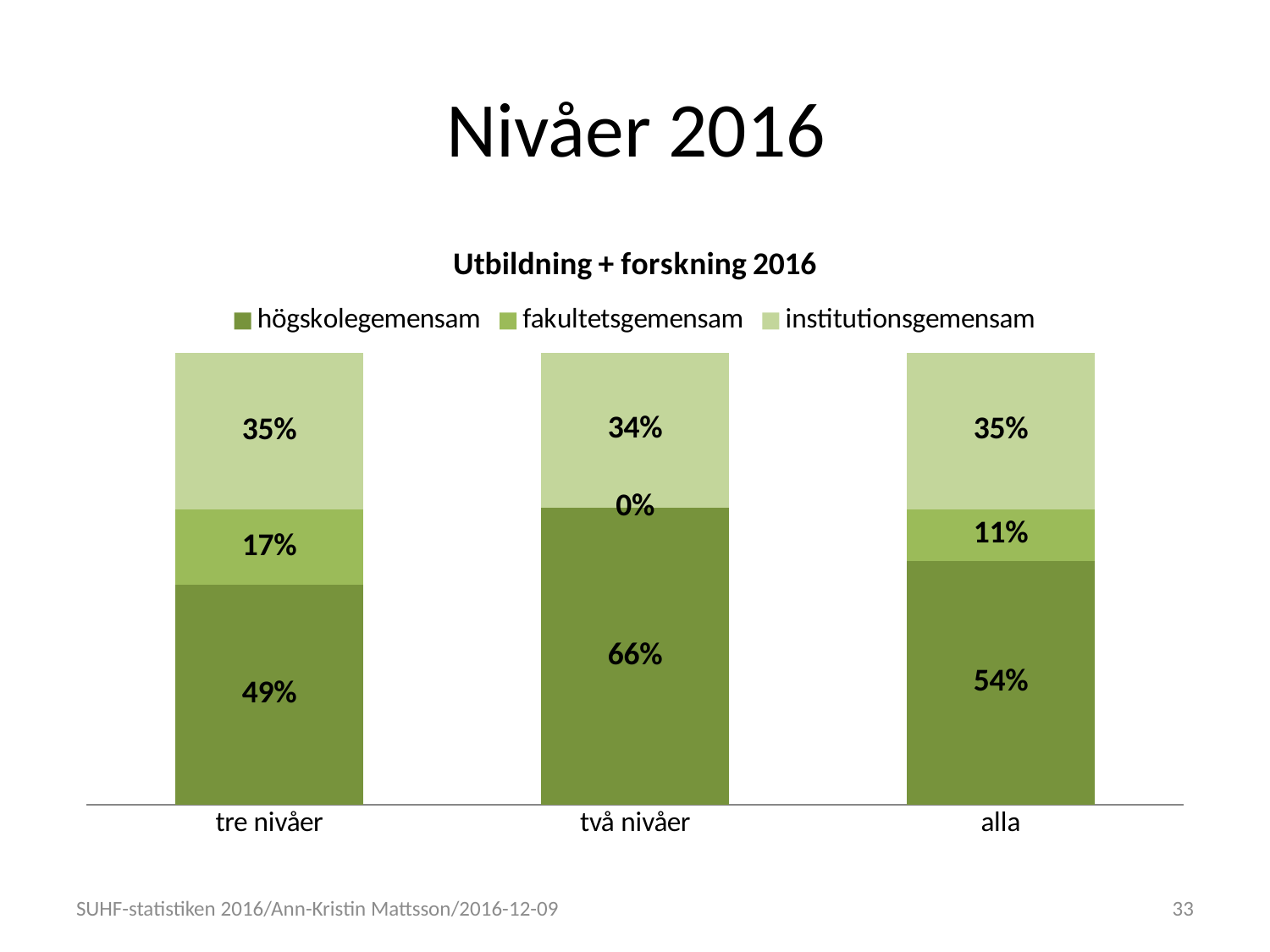
What kind of chart is shown? stacked bar chart What is the value for högskolegemensam in the tre nivåer bar? 49% What is the value for fakultetsgemensam in the två nivåer bar? 0% How many categories are shown on the x axis? 3 Which is larger: the fakultetsgemensam value for tre nivåer or for alla? tre nivåer Which category has the highest value for högskolegemensam? två nivåer What is the difference between the högskolegemensam values for två nivåer and tre nivåer? 17% How many series does the legend list? 3 What is the value for institutionsgemensam in the två nivåer bar? 34% Which category has the lowest value for fakultetsgemensam? två nivåer What is the title of the chart? Utbildning + forskning 2016 What is the value for fakultetsgemensam in the alla bar? 11%